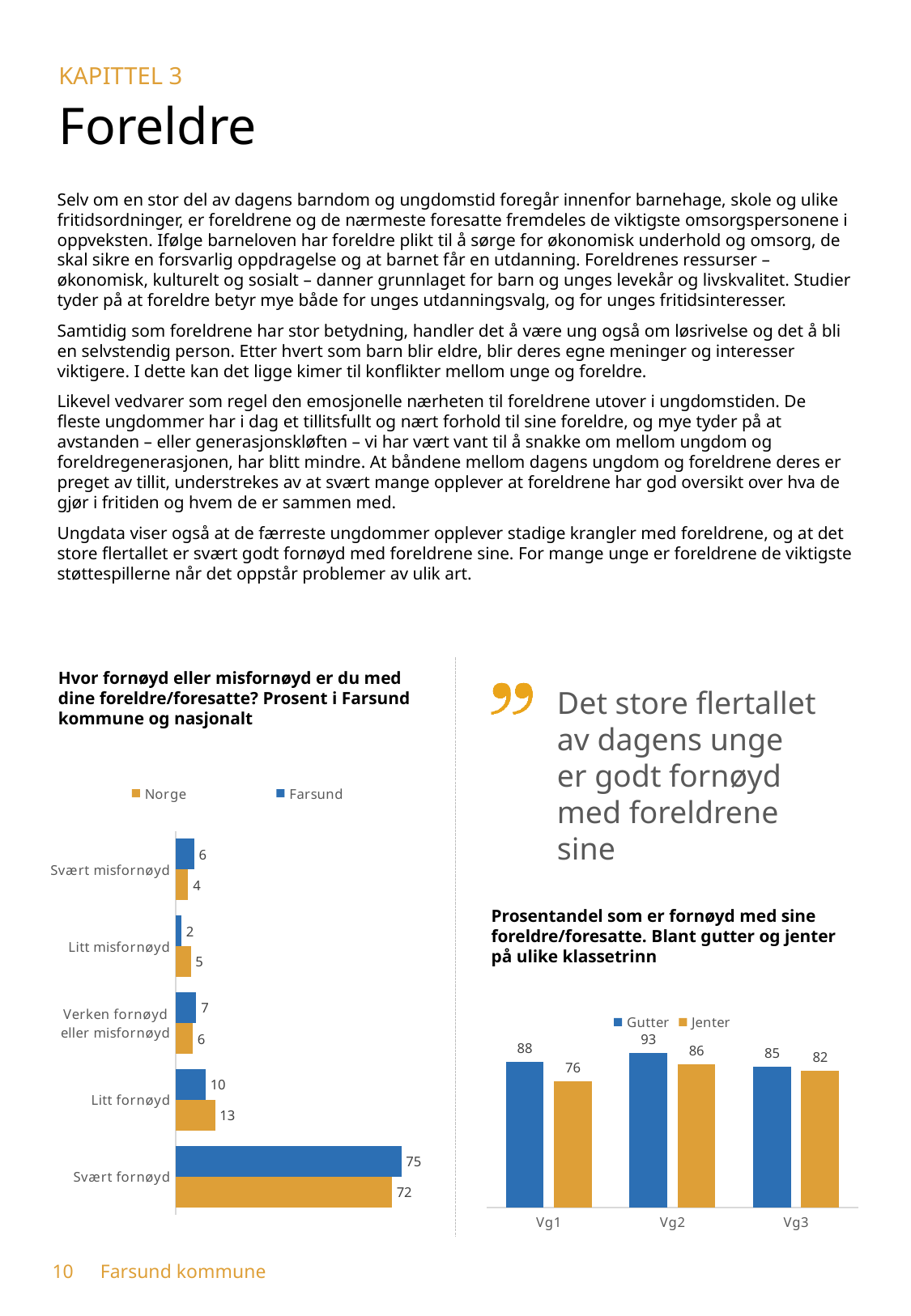
In the left chart (Hvor fornøyd eller misfornøyd er du med dine foreldre/foresatte?), what is the Norge value for Litt fornøyd? 13 What kind of chart is the left chart (Hvor fornøyd eller misfornøyd er du med dine foreldre/foresatte?)? Bar chart In the left chart (Hvor fornøyd eller misfornøyd er du med dine foreldre/foresatte?), what is the difference between the Farsund and Norge values for Svært fornøyd? 3 In the left chart (Hvor fornøyd eller misfornøyd er du med dine foreldre/foresatte?), what is the Farsund value for Svært fornøyd? 75 In the right chart (Prosentandel som er fornøyd med sine foreldre/foresatte), which colour represents Jenter in the legend? Orange In the left chart (Hvor fornøyd eller misfornøyd er du med dine foreldre/foresatte?), which category has the lowest Farsund value? Litt misfornøyd In the right chart (Prosentandel som er fornøyd med sine foreldre/foresatte), what is the Gutter value for Vg2? 93 In the left chart (Hvor fornøyd eller misfornøyd er du med dine foreldre/foresatte?), how many categories are shown? 5 In the right chart (Prosentandel som er fornøyd med sine foreldre/foresatte), what is the difference between the Gutter and Jenter values for Vg1? 12 In the left chart (Hvor fornøyd eller misfornøyd er du med dine foreldre/foresatte?), which is larger for Litt misfornøyd, the Norge value or the Farsund value? Norge In the right chart (Prosentandel som er fornøyd med sine foreldre/foresatte), which class level has the lowest Jenter value? Vg1 In the left chart (Hvor fornøyd eller misfornøyd er du med dine foreldre/foresatte?), how many series does the legend list? 2